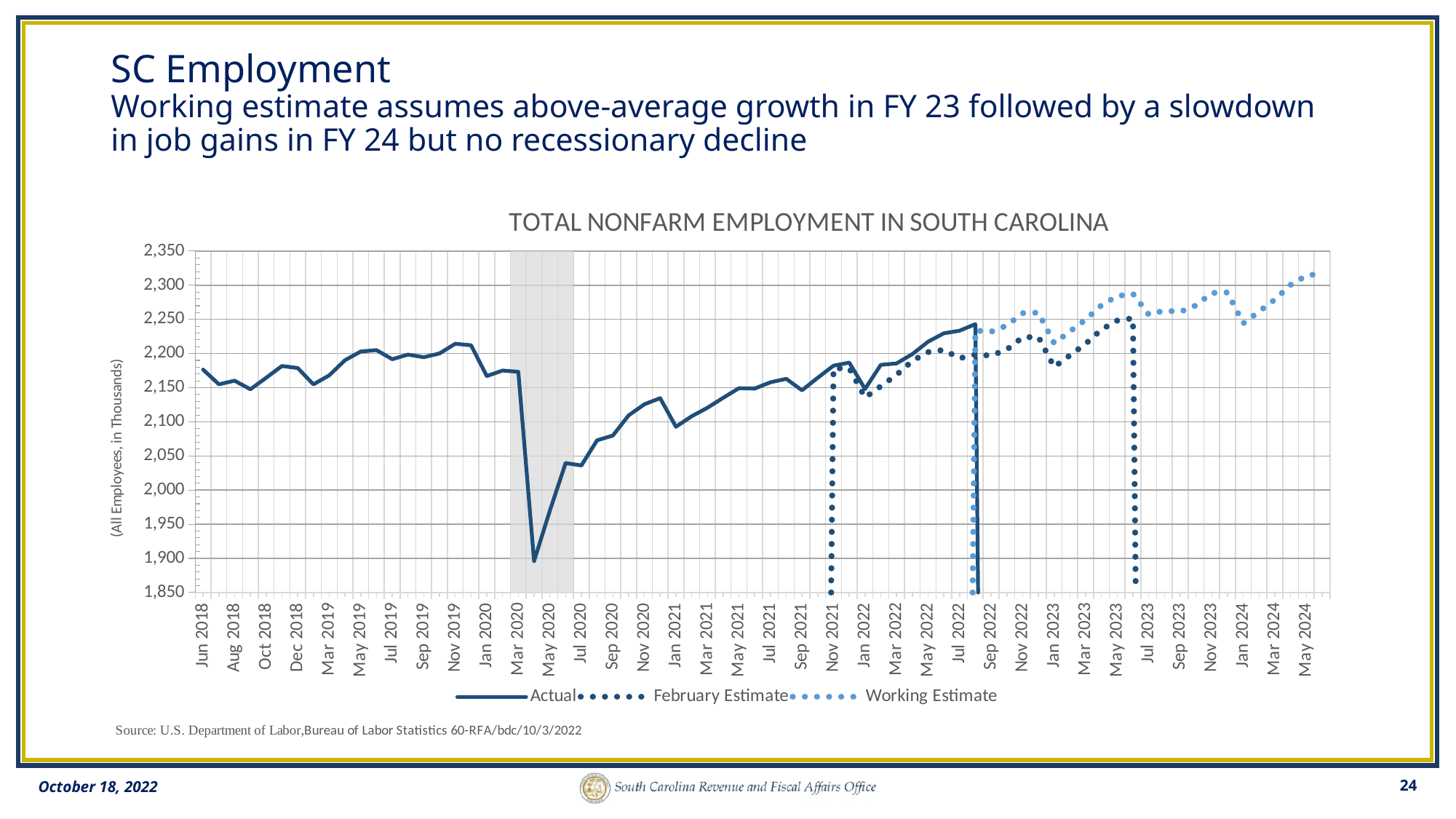
Does the Actual series rise or fall between May 2020 and Jul 2022? rise Is the Working Estimate value for May 2024 greater or less than 2,300? greater Is the lowest point of the Actual series greater or less than 1,950? less How many series does the chart legend list? 3 What is the title of the chart? TOTAL NONFARM EMPLOYMENT IN SOUTH CAROLINA Is the February Estimate value for May 2023 greater or less than 2,300? less What are the three series named in the chart legend? Actual, February Estimate, Working Estimate What kind of chart is shown on the slide? line chart In which year does the Actual series reach its lowest value? 2020 At Jan 2023, which series is higher: the Working Estimate or the February Estimate? Working Estimate